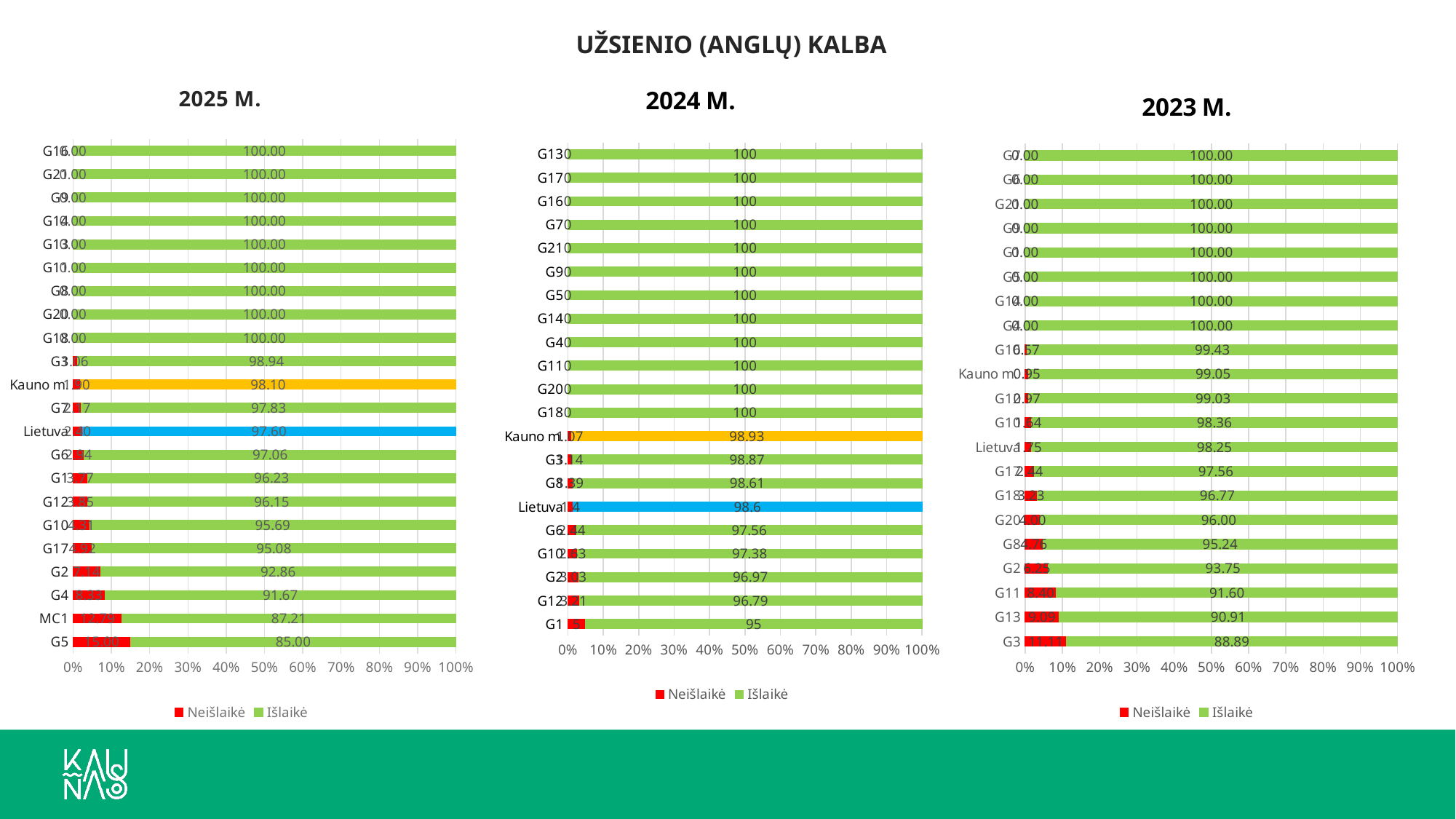
In the 2023 M. chart, what is the difference between the Išlaikė values for Kauno m. and Lietuva? 0.80 In the 2023 M. chart, what is the Išlaikė value for G3? 88.89 What kind of chart is the 2023 M. chart? Stacked bar chart How many series does the legend of the 2024 M. chart list? 2 In the 2024 M. chart, what is the Išlaikė value for Lietuva? 98.6 In the 2025 M. chart, which has the larger Išlaikė value, MC1 or G4? G4 In the 2024 M. chart, how many categories are plotted? 21 In the 2024 M. chart, which category has the lowest Išlaikė value? G1 In the 2023 M. chart, what is the Neišlaikė value for G13? 9.09 In the 2025 M. chart, what is the Išlaikė value for G5? 85.00 In the 2025 M. chart, what is the Išlaikė value for Kauno m.? 98.10 In the 2025 M. chart, which category has the lowest Išlaikė value? G5